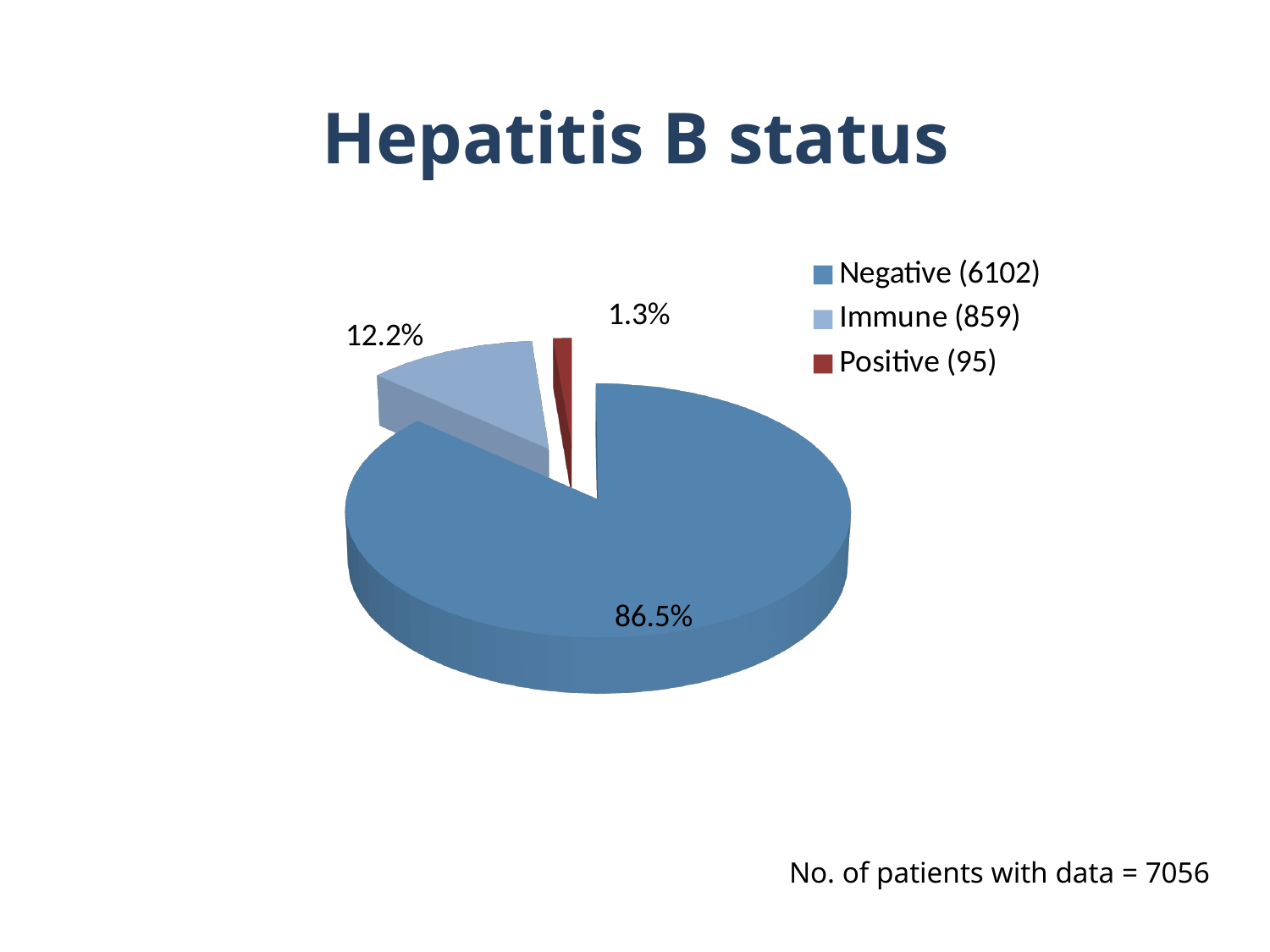
What is the title of the chart? Hepatitis B status How many patients are listed as Immune in the legend? 859 What is the difference in percentage points between the Immune and Positive slices? 10.9 What kind of chart is shown on the slide? pie chart How many categories does the pie chart show? 3 Which category has the smallest share of the pie? Positive Which is larger, the Immune slice or the Positive slice? Immune What percentage of patients are Positive? 1.3% Which category has the largest share of the pie? Negative What percentage of patients are Negative? 86.5% How many entries does the legend list? 3 What percentage of patients are Immune? 12.2%